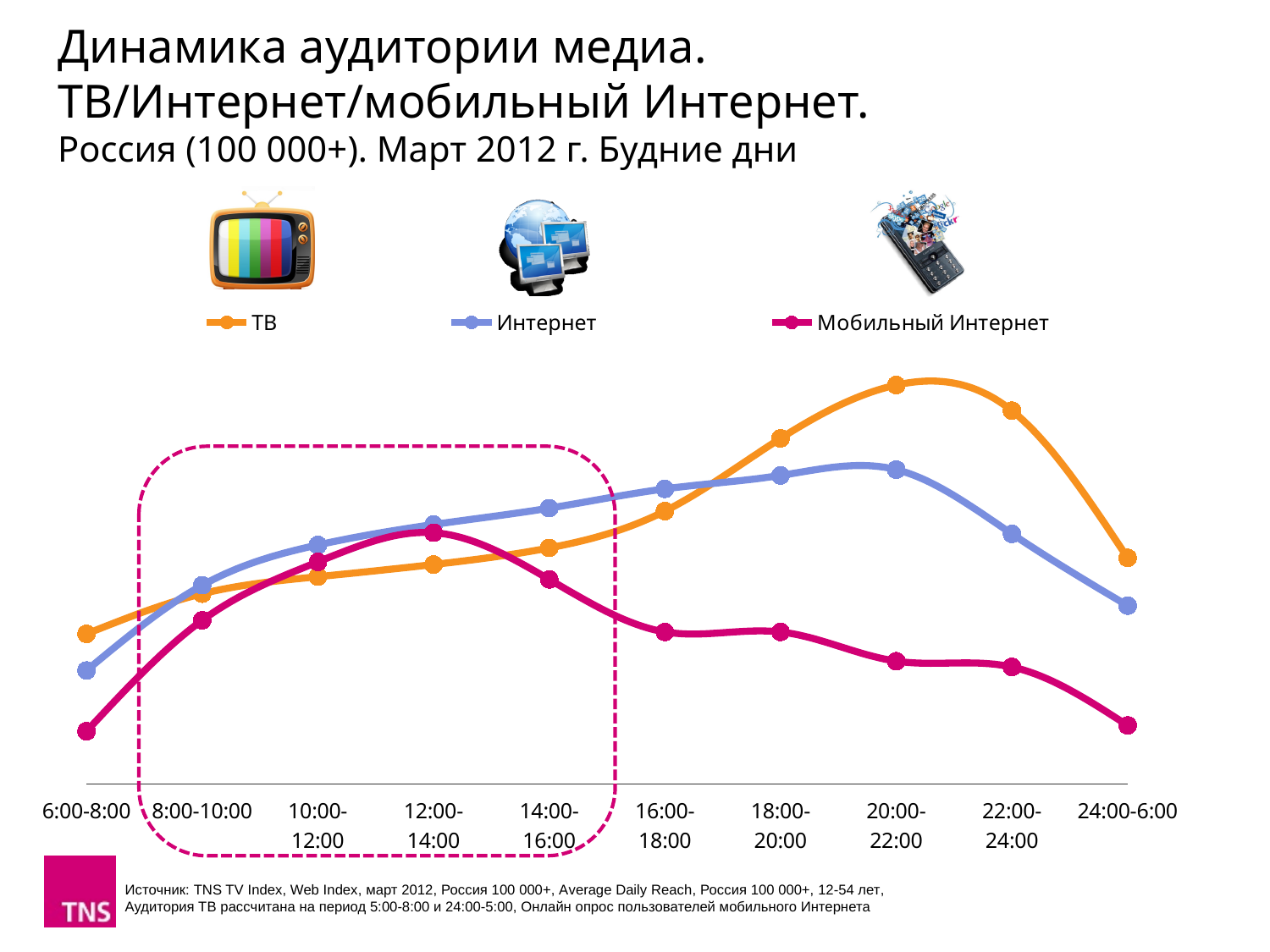
How many time intervals are shown along the x axis? 10 What kind of chart is shown on the slide? line chart In which time interval does the Мобильный Интернет series reach its highest value? 12:00-14:00 At 12:00-14:00, which series is higher, Интернет or ТВ? Интернет In which time interval is the Интернет series at its lowest? 6:00-8:00 In which time interval does the ТВ series reach its highest value? 20:00-22:00 What colour is the line for the ТВ series? orange How many series does the legend list? 3 In which time interval does the Интернет series reach its highest value? 20:00-22:00 Does the ТВ series rise or fall from 20:00-22:00 to 24:00-6:00? fall Does the Мобильный Интернет series rise or fall from 6:00-8:00 to 12:00-14:00? rise At 20:00-22:00, which series is higher, ТВ or Интернет? ТВ